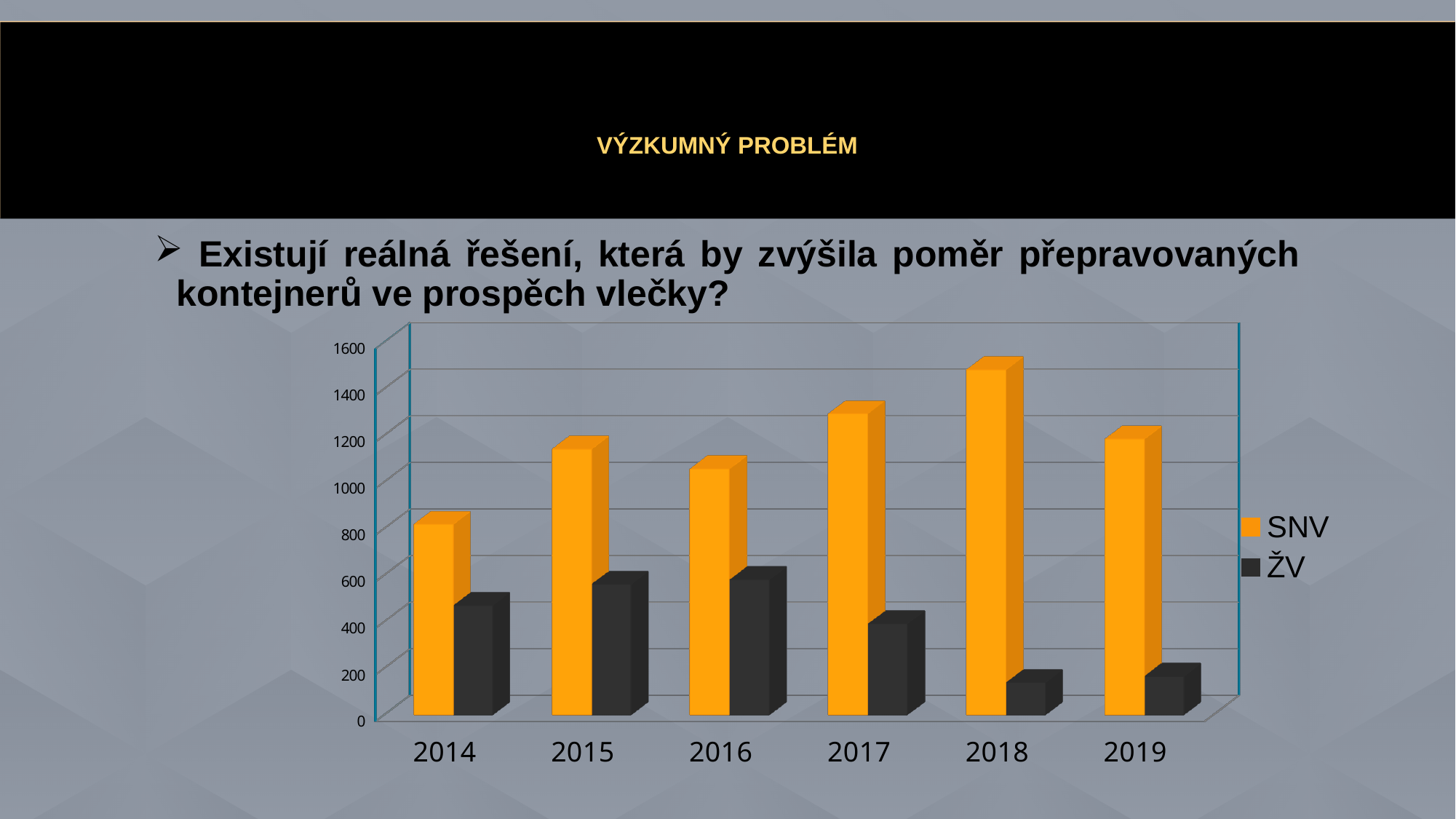
Do the ŽV values rise or fall from 2016 to 2018? fall How many years are shown on the x axis of the chart? 6 Is the SNV value for 2014 greater or less than 1000? less Is the ŽV value for 2016 greater or less than 400? greater In 2014, which series has the larger value, SNV or ŽV? SNV Which year has the highest SNV value? 2018 Which year has the lowest SNV value? 2014 Which colour represents the SNV series in the chart? orange What kind of chart is shown on the slide? bar chart Is the SNV value for 2018 greater or less than 1400? greater How many series does the chart legend list? 2